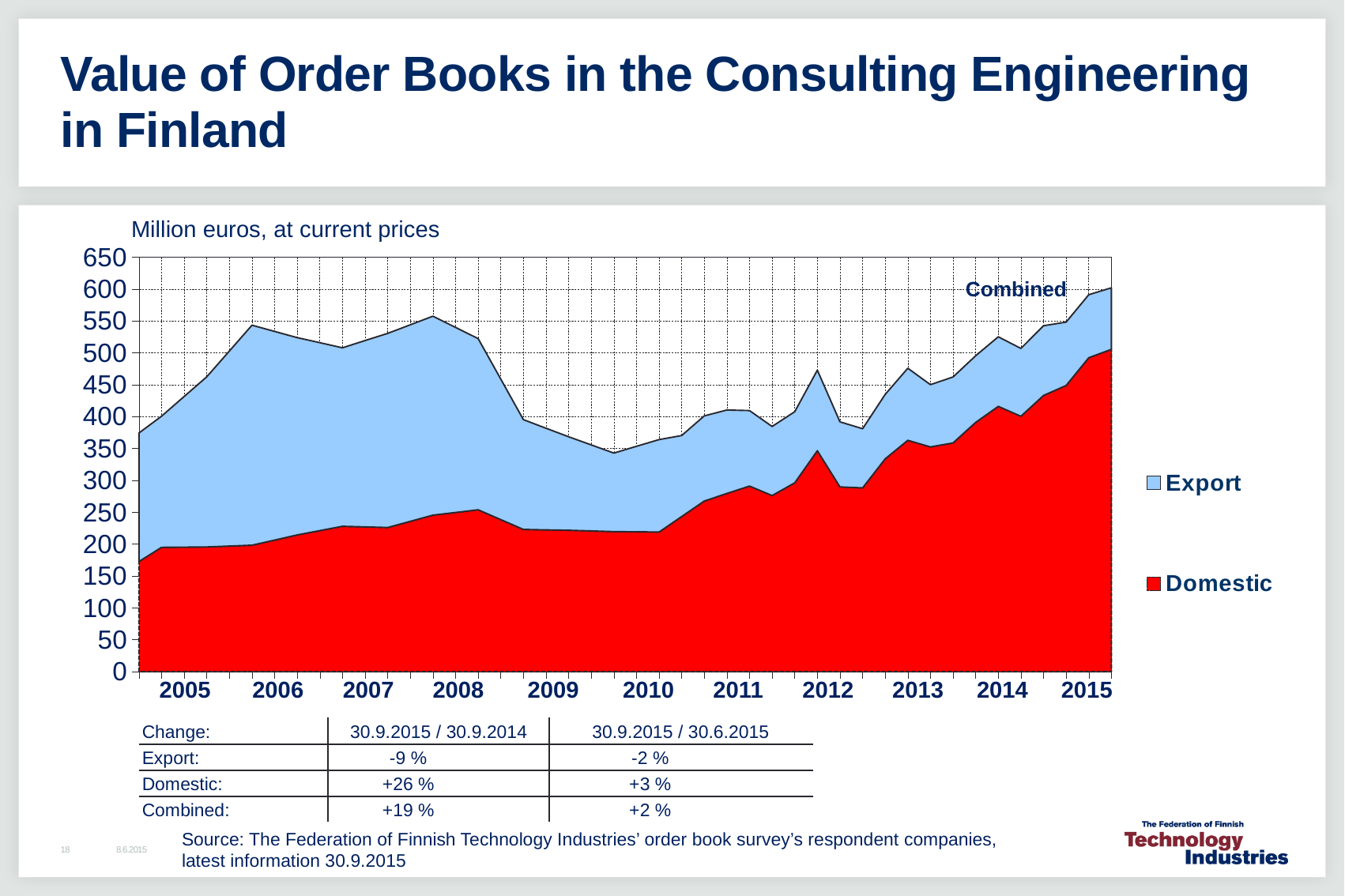
In 2006, which series is larger, Export or Domestic? Export What unit is stated above the chart for the values? Million euros, at current prices Is the Domestic value in 2010 greater or less than 250? less What kind of chart is shown on the slide? Stacked area chart Which two series are listed in the legend? Export and Domestic Does the Domestic value rise or fall overall from 2005 to 2015? rise In 2015, which series is larger, Export or Domestic? Domestic How many years are labelled on the x axis? 11 Is the Combined value at the 2008 peak greater or less than 500? greater How many series does the legend list? 2 Is the Domestic value in 2013 greater or less than 300? greater